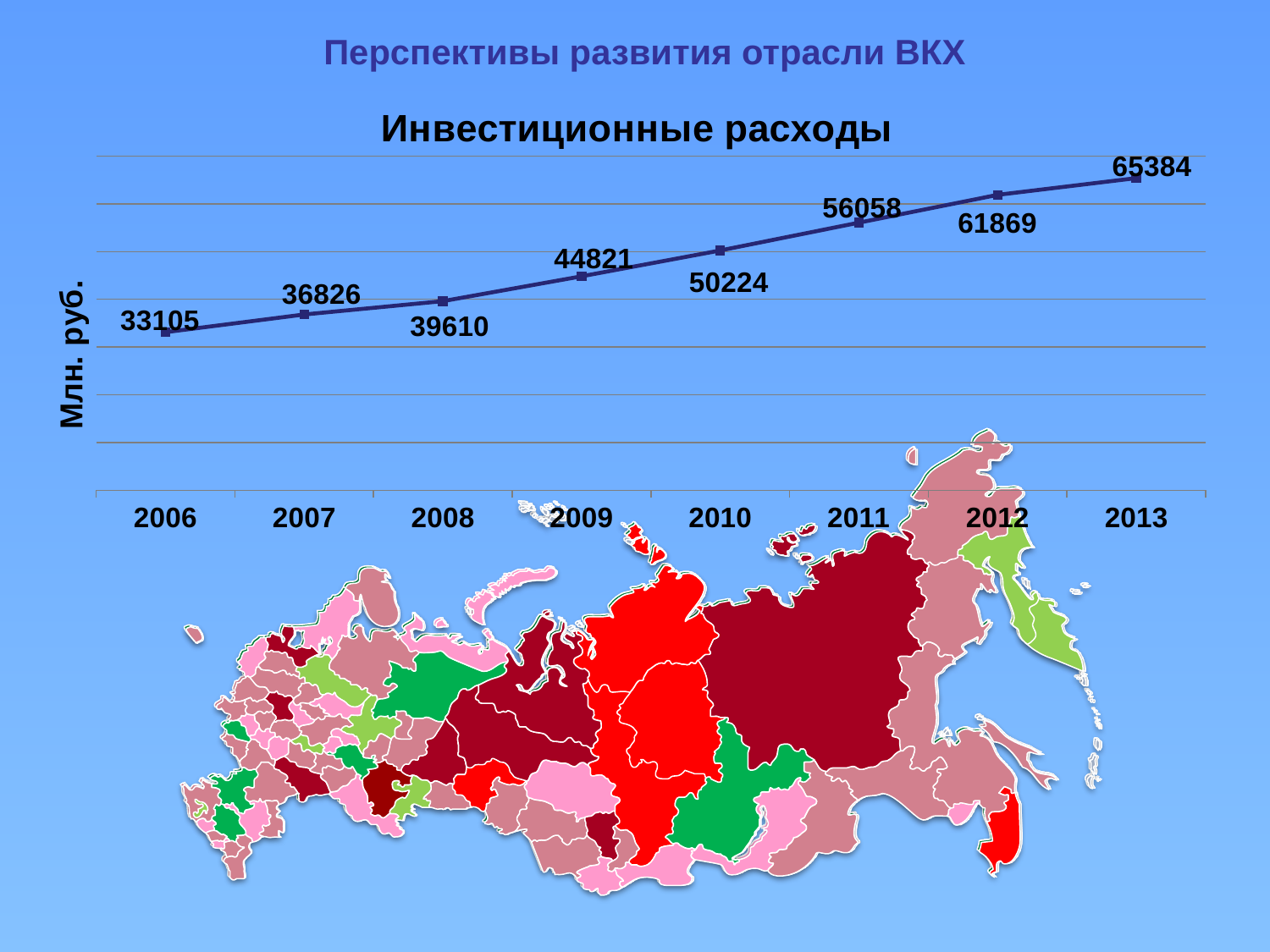
What is the value for 2010 in the 'Инвестиционные расходы' chart? 50224 Which is larger in the 'Инвестиционные расходы' chart, the value for 2009 or the value for 2010? 2010 Do the values in the 'Инвестиционные расходы' chart rise or fall from 2006 to 2013? rise What is the value for 2013 in the 'Инвестиционные расходы' chart? 65384 What kind of chart is 'Инвестиционные расходы'? line chart Which year has the highest value in the 'Инвестиционные расходы' chart? 2013 What is the difference between the values for 2012 and 2011 in the 'Инвестиционные расходы' chart? 5811 Which year has the lowest value in the 'Инвестиционные расходы' chart? 2006 What is the value for 2008 in the 'Инвестиционные расходы' chart? 39610 What is the difference between the values for 2013 and 2006 in the 'Инвестиционные расходы' chart? 32279 What is the value for 2006 in the 'Инвестиционные расходы' chart? 33105 How many years are plotted in the 'Инвестиционные расходы' chart? 8